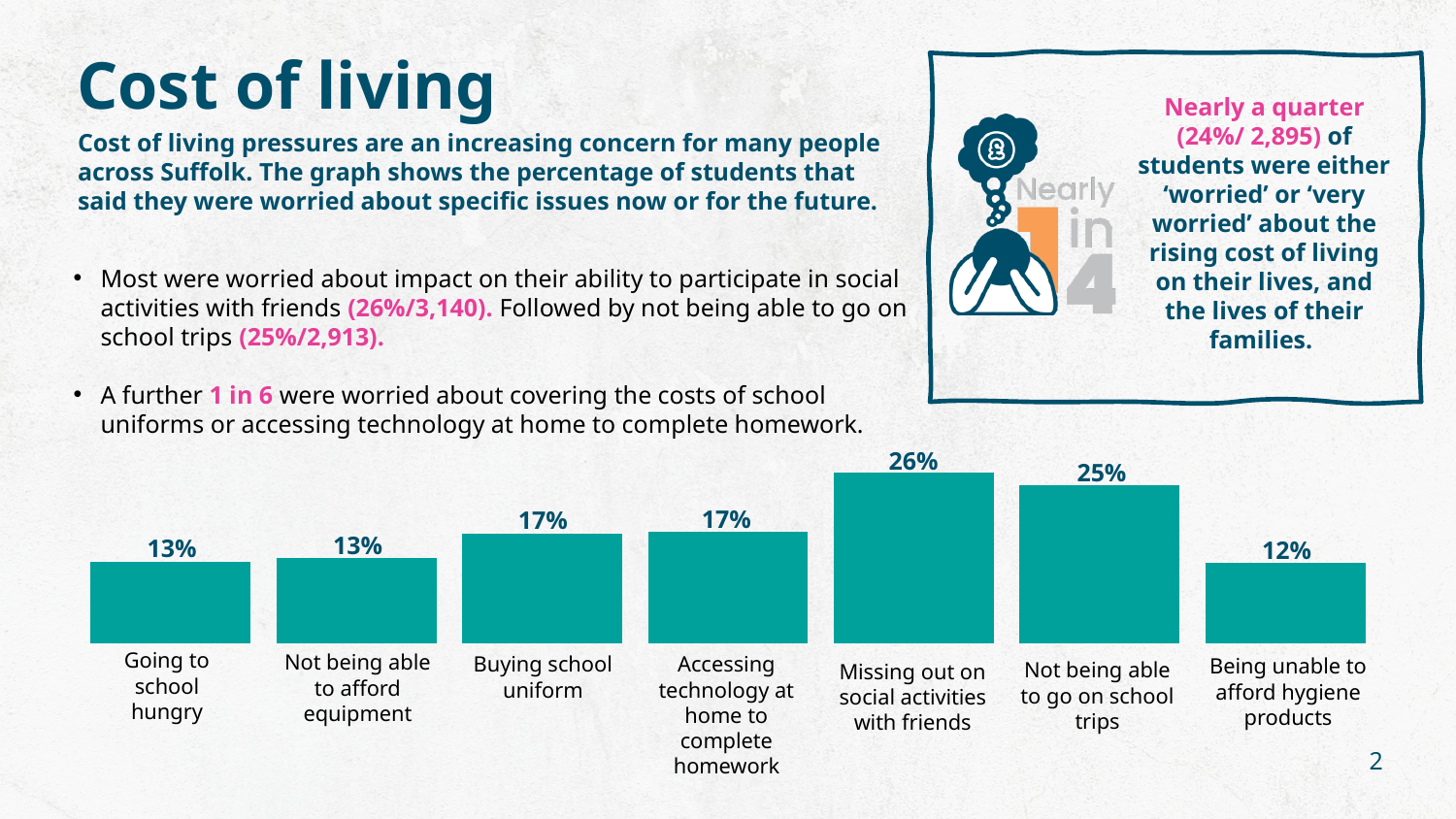
Which is larger: the percentage for 'Buying school uniform' or for 'Not being able to afford equipment'? Buying school uniform How many categories are shown in the chart? 7 What percentage of students said they were worried about going to school hungry? 13% What percentage of students were worried about being unable to afford hygiene products? 12% Which category has the highest percentage in the chart? Missing out on social activities with friends What is the difference in percentage points between 'Missing out on social activities with friends' and 'Going to school hungry'? 13 What is the difference in percentage points between 'Not being able to go on school trips' and 'Being unable to afford hygiene products'? 13 What type of chart is shown on the slide? Bar chart Which category has the lowest percentage in the chart? Being unable to afford hygiene products What percentage of students were worried about missing out on social activities with friends? 26% What colour are the bars in the chart? Teal What percentage of students were worried about accessing technology at home to complete homework? 17%